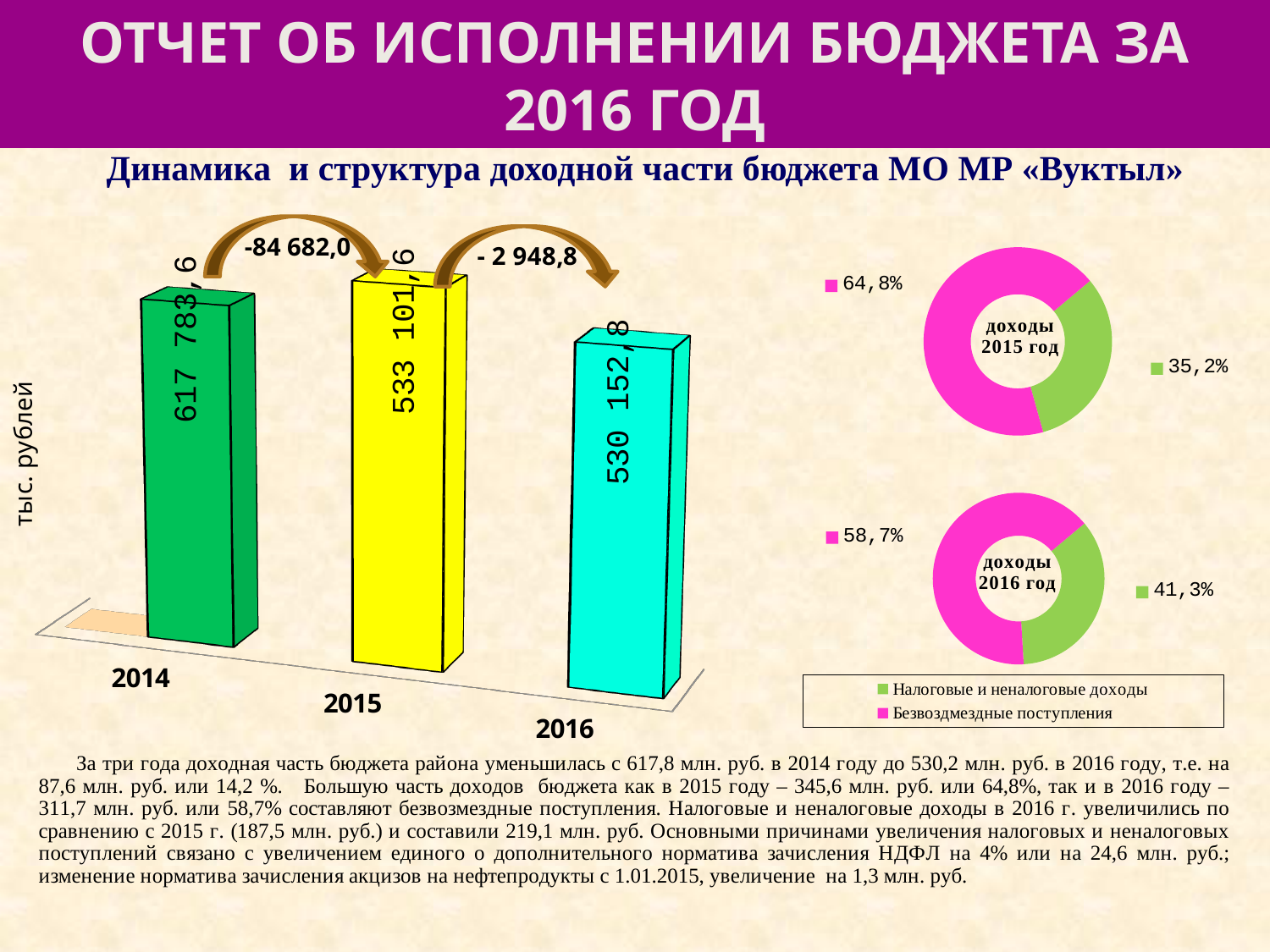
In the bar chart, which year has the highest value? 2014 In the donut chart 'доходы 2016 год', what share is Налоговые и неналоговые доходы? 41,3% What kind of chart shows the values for 2014, 2015 and 2016? bar chart How many years are shown in the bar chart? 3 In the bar chart, what is the value for 2014? 617 783,6 In the bar chart, do the values rise or fall from 2014 to 2016? fall In the bar chart, what is the value for 2016? 530 152,8 In the bar chart, what is the difference between the 2014 and 2015 values? 84 682,0 In the donut chart 'доходы 2015 год', what share is Безвозмездные поступления? 64,8% In the bar chart, what is the value for 2015? 533 101,6 In the bar chart, which year has the lowest value? 2016 In the bar chart, what is the difference between the 2015 and 2016 values? 2 948,8